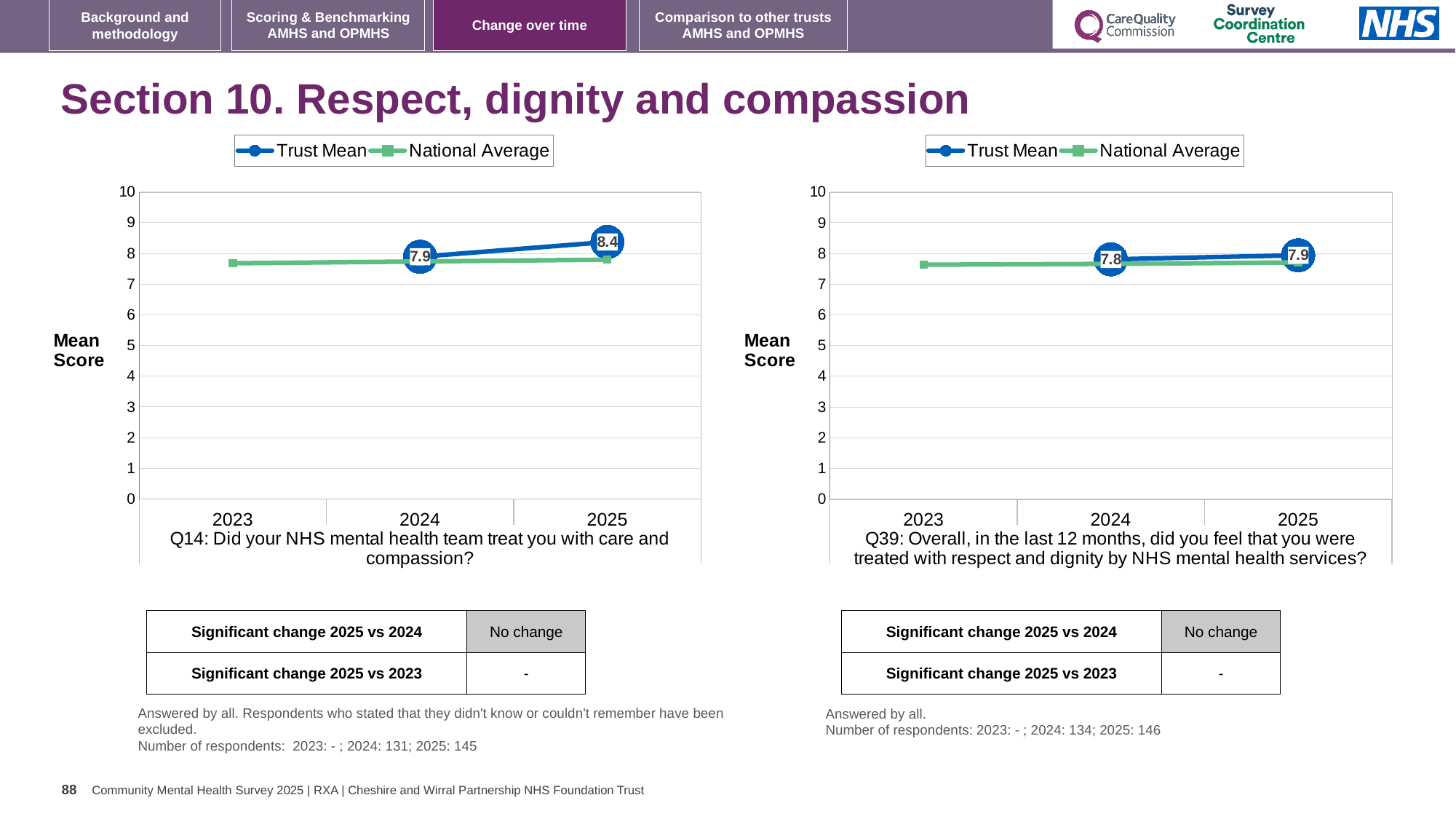
On the right chart (Q39), is the National Average value for 2025 greater or less than 8? less On the left chart (Q14), does the Trust Mean rise or fall from 2024 to 2025? rise What type of chart is shown on the left of the slide? line chart How many years are shown on the x axis of the left chart (Q14)? 3 How many series does the legend of the right chart (Q39) list? 2 On the left chart (Q14), by how much did the Trust Mean change from 2024 to 2025? 0.5 On the right chart (Q39), what is the difference between the Trust Mean in 2025 and in 2024? 0.1 On the left chart (Q14), is the Trust Mean higher in 2024 or in 2025? 2025 On the left chart (Q14), what is the Trust Mean score for 2024? 7.9 On the right chart (Q39), what is the Trust Mean score for 2025? 7.9 On the left chart (Q14), what is the Trust Mean score for 2025? 8.4 On the right chart (Q39), what is the Trust Mean score for 2024? 7.8